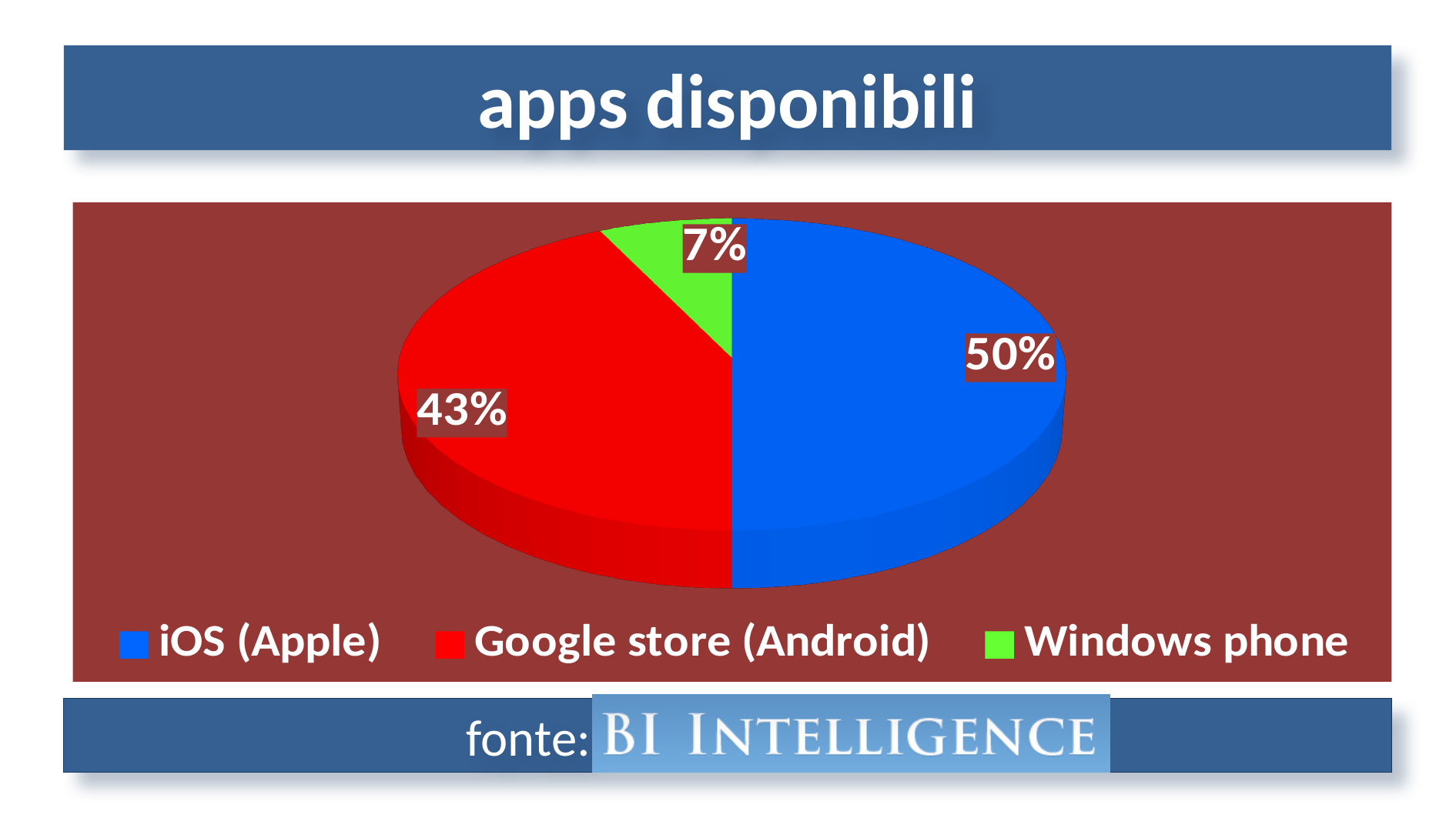
What is the difference in percentage points between the iOS (Apple) share and the Google store (Android) share? 7 Which has a larger share, Google store (Android) or Windows phone? Google store (Android) What is the difference in percentage points between the Google store (Android) share and the Windows phone share? 36 Which platform has the largest share of available apps? iOS (Apple) What share of available apps does iOS (Apple) have? 50% What type of chart is shown on the slide? pie chart What share of available apps does Windows phone have? 7% What is the title of the slide? apps disponibili How many slices does the pie chart have? 3 Which platform has the smallest share of available apps? Windows phone What share of available apps does Google store (Android) have? 43% What colour is the Windows phone slice? green